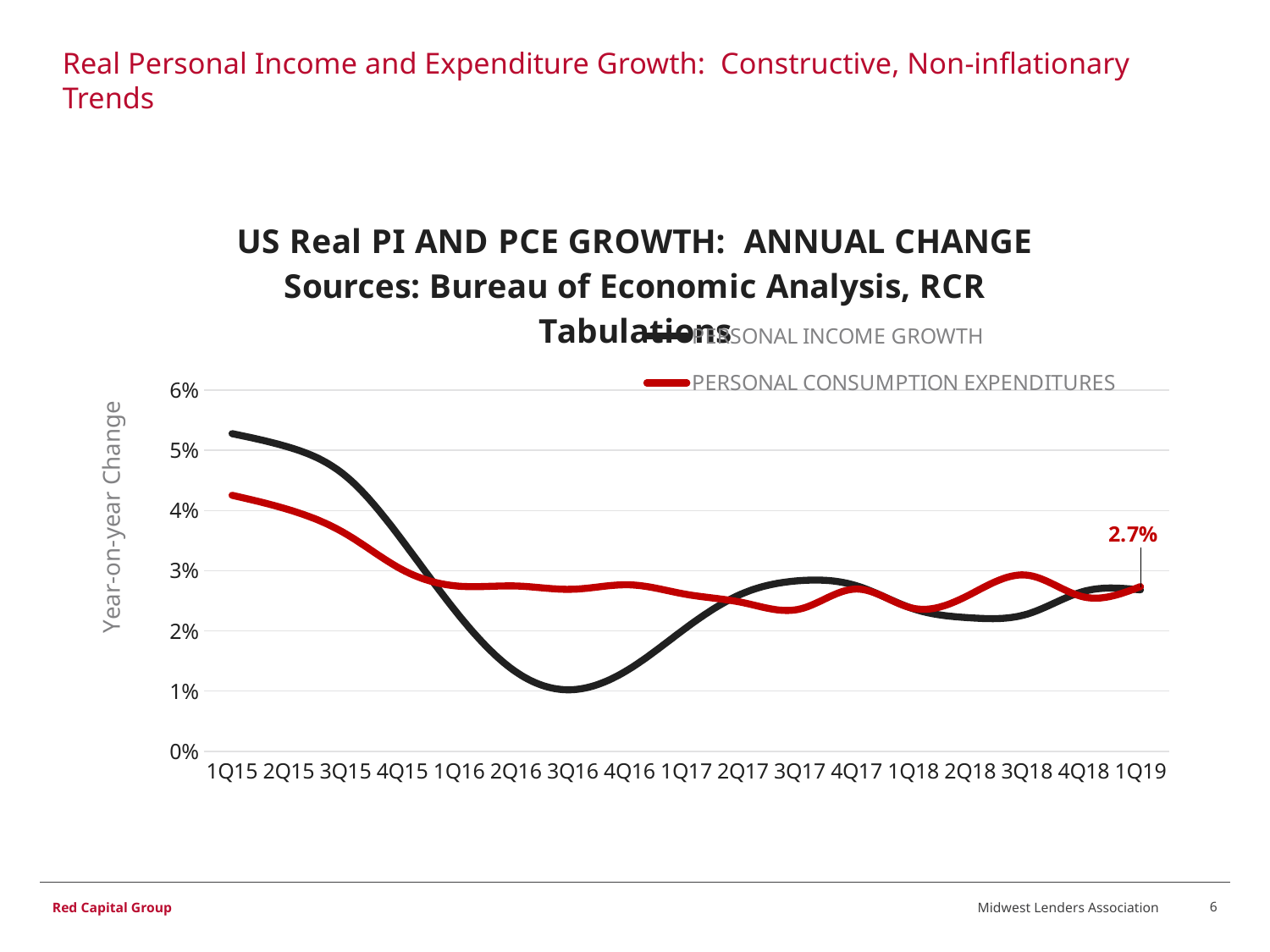
At 3Q16, which series has the higher value, Personal Income Growth or Personal Consumption Expenditures? Personal Consumption Expenditures At 1Q15, which series has the higher value, Personal Income Growth or Personal Consumption Expenditures? Personal Income Growth In which quarter does the Personal Income Growth line reach its lowest point? 3Q16 What kind of chart is shown on the slide? line chart What is the labelled value for Personal Consumption Expenditures at 1Q19? 2.7% Does the Personal Income Growth line rise or fall from 1Q15 to 3Q16? fall How many series does the legend list? 2 Is the value for Personal Consumption Expenditures at 1Q15 greater or less than 4%? greater How many quarters are plotted along the x axis? 17 In which quarter does the Personal Consumption Expenditures line reach its highest point? 1Q15 Is the value for Personal Income Growth at 3Q16 greater or less than 2%? less Is the value for Personal Income Growth at 1Q15 greater or less than 5%? greater